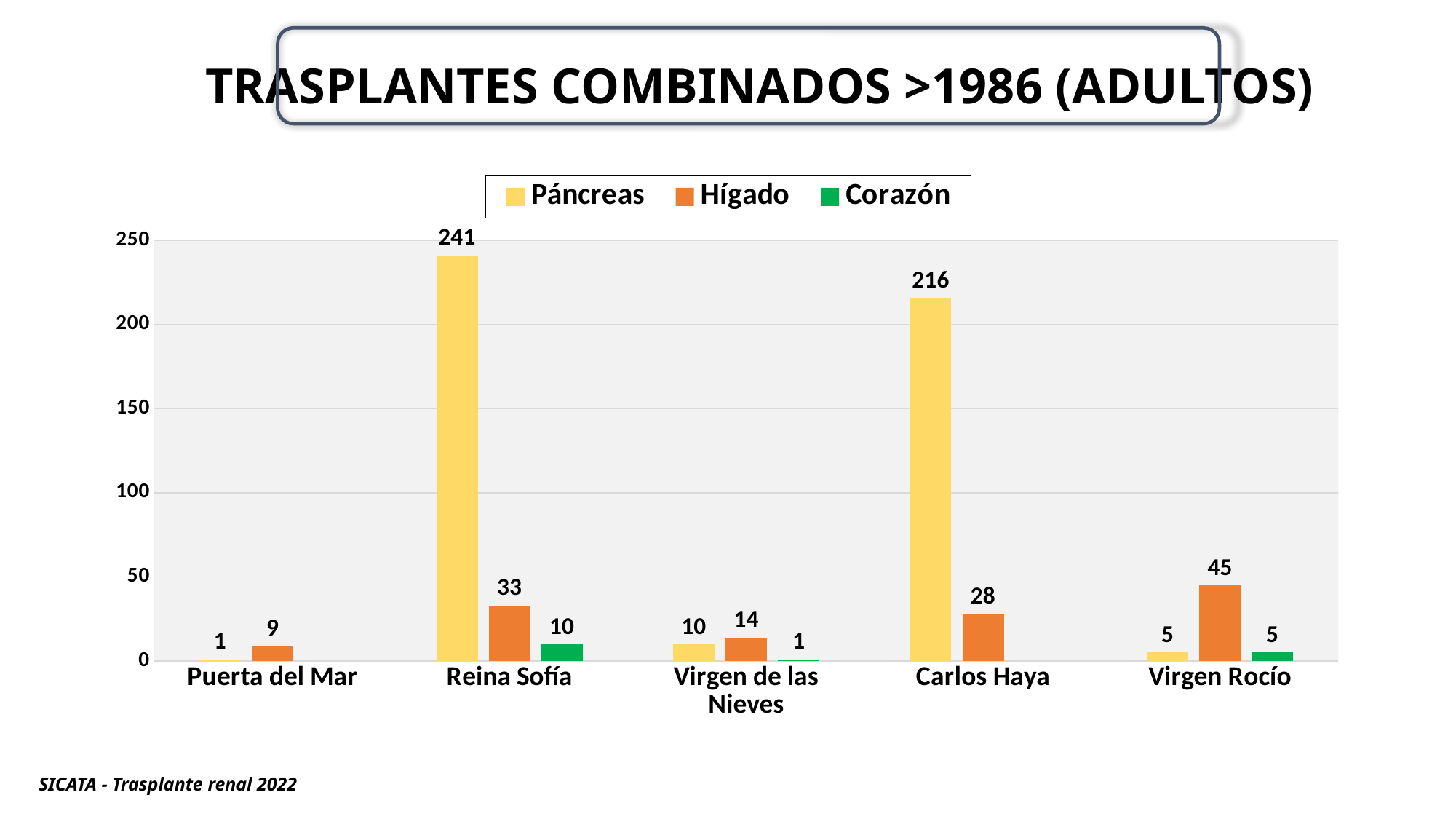
What is the title of the chart? TRASPLANTES COMBINADOS >1986 (ADULTOS) What kind of chart is shown on the slide? Bar chart Which hospital has the highest Hígado value? Virgen Rocío What is the difference between the Páncreas values for Reina Sofía and Carlos Haya? 25 What is the Hígado value for Virgen Rocío? 45 How many hospitals are shown on the x axis? 5 How many series does the legend list? 3 Which is larger, the Hígado value for Reina Sofía or for Carlos Haya? Reina Sofía Which hospital has the highest Páncreas value? Reina Sofía What is the Páncreas value for Reina Sofía? 241 What is the Corazón value for Reina Sofía? 10 Which hospital has the lowest Páncreas value? Puerta del Mar